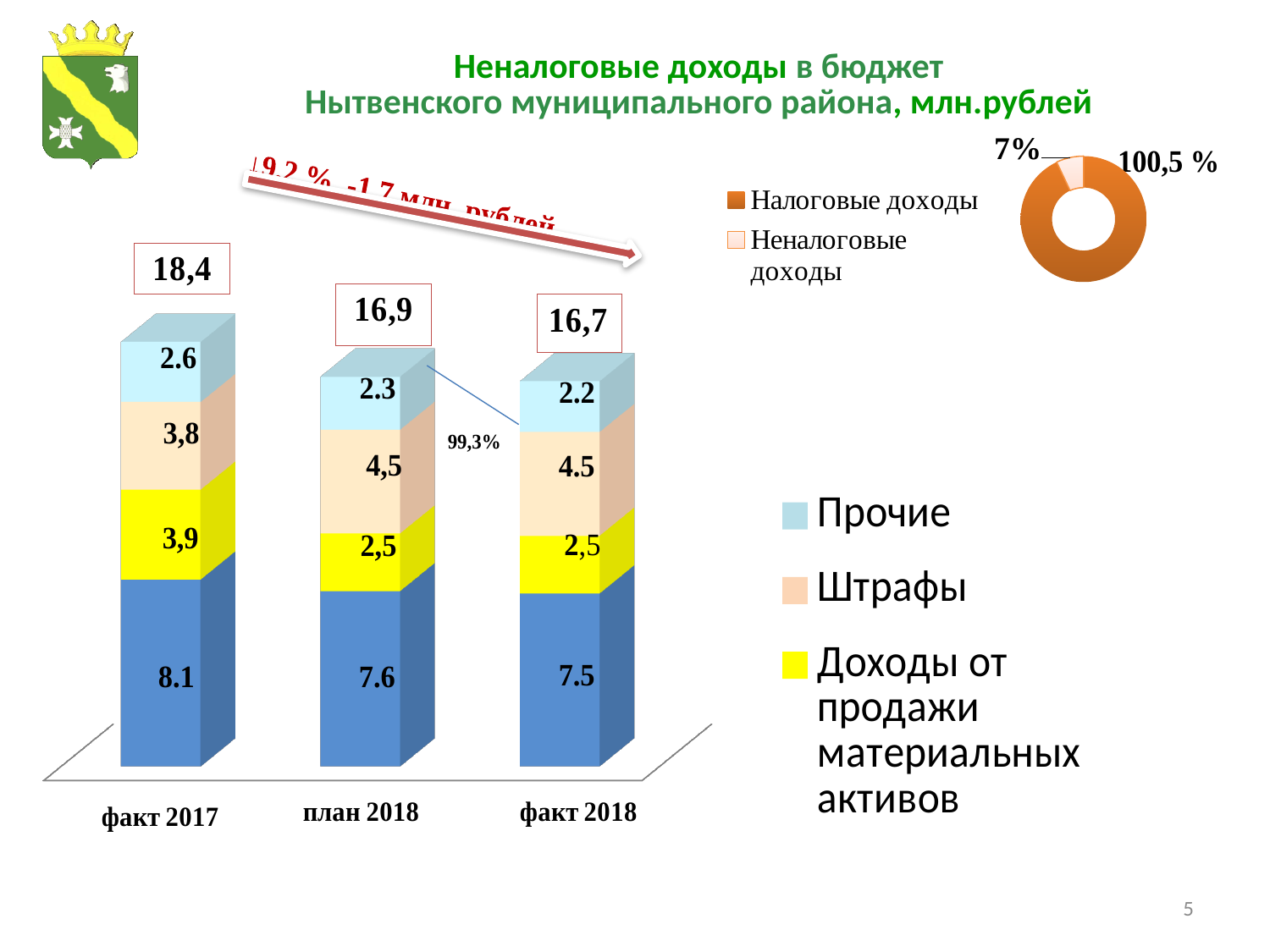
In the stacked bar chart, what is the value of the Штрафы segment for факт 2017? 3,8 In the stacked bar chart, what is the total value shown above the bar for факт 2017? 18,4 What are the two legend entries of the donut chart in the top right? Налоговые доходы, Неналоговые доходы In the stacked bar chart, which category has the lowest total? факт 2018 In the stacked bar chart, what is the value of the Прочие segment for план 2018? 2.3 In the stacked bar chart, which category has the highest total? факт 2017 In the stacked bar chart, what is the difference between the bottom (blue) segment values for факт 2017 and факт 2018? 0.6 In the stacked bar chart, what is the total value shown above the bar for план 2018? 16,9 How many categories are shown on the x axis of the stacked bar chart? 3 In the stacked bar chart, is the Штрафы segment larger for факт 2017 or for план 2018? план 2018 In the stacked bar chart, what is the total value shown above the bar for факт 2018? 16,7 In the stacked bar chart, what is the value of the Доходы от продажи материальных активов segment for факт 2018? 2,5